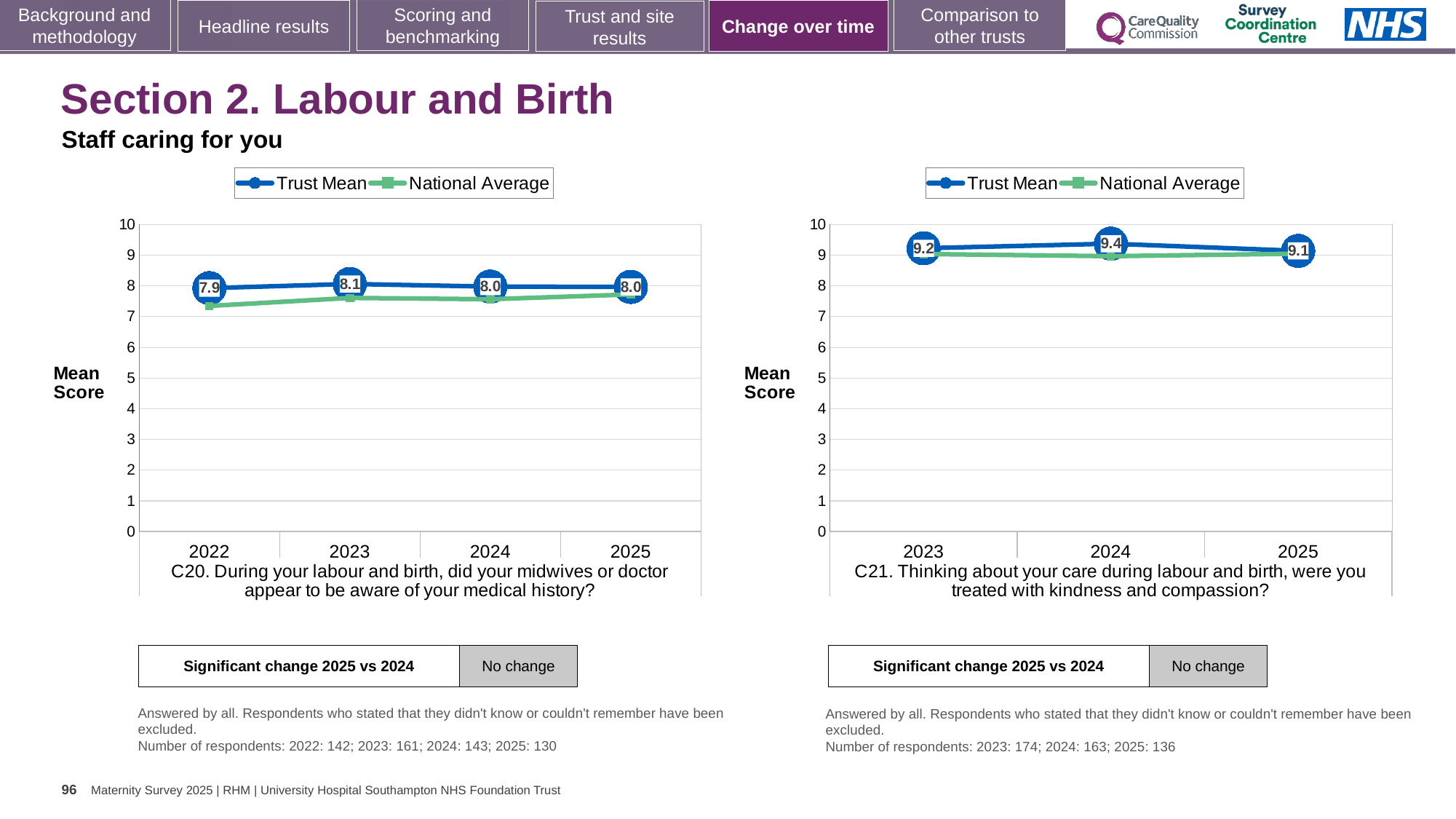
In the left chart (C20), is the National Average value for 2022 greater or less than 8? less How many series does the legend of the left chart (C20) list? 2 In the right chart (C21), what is the Trust Mean score for 2025? 9.1 In the right chart (C21), which year has the lowest Trust Mean score? 2025 In the right chart (C21), what is the difference between the Trust Mean scores for 2024 and 2025? 0.3 In the left chart (C20), for 2022, which is higher: the Trust Mean or the National Average? Trust Mean In the right chart (C21), does the Trust Mean rise or fall from 2024 to 2025? Fall How many years are plotted in the right chart (C21)? 3 In the left chart (C20), what is the Trust Mean score for 2023? 8.1 In the left chart (C20), what is the difference between the Trust Mean scores for 2023 and 2022? 0.2 What kind of chart is the left chart (C20)? Line chart In the left chart (C20), which year has the highest Trust Mean score? 2023